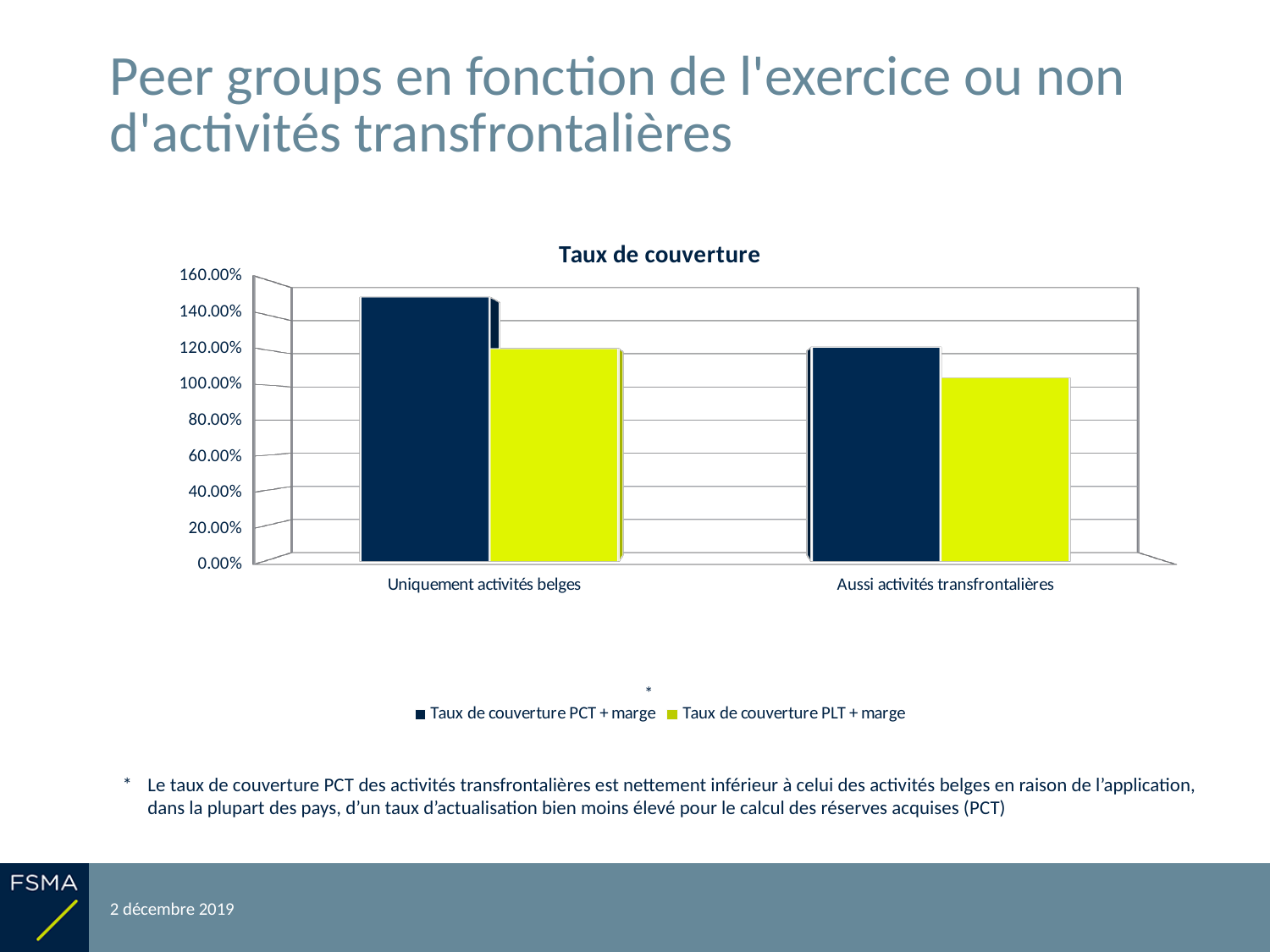
Which category has the lowest value for Taux de couverture PLT + marge? Aussi activités transfrontalières For Uniquement activités belges, which series has the larger value: Taux de couverture PCT + marge or Taux de couverture PLT + marge? Taux de couverture PCT + marge How many series does the chart legend list? 2 Which category has the highest value for Taux de couverture PCT + marge? Uniquement activités belges What kind of chart is shown on the slide? bar chart Is the value of Taux de couverture PCT + marge for Aussi activités transfrontalières greater or less than 100.00%? greater How many categories are shown on the x axis of the chart? 2 Is the value of Taux de couverture PLT + marge for Uniquement activités belges greater or less than 100.00%? greater Is the value of Taux de couverture PCT + marge for Uniquement activités belges greater or less than 140.00%? greater Which series is drawn in yellow-green in the chart? Taux de couverture PLT + marge What is the title of the chart? Taux de couverture